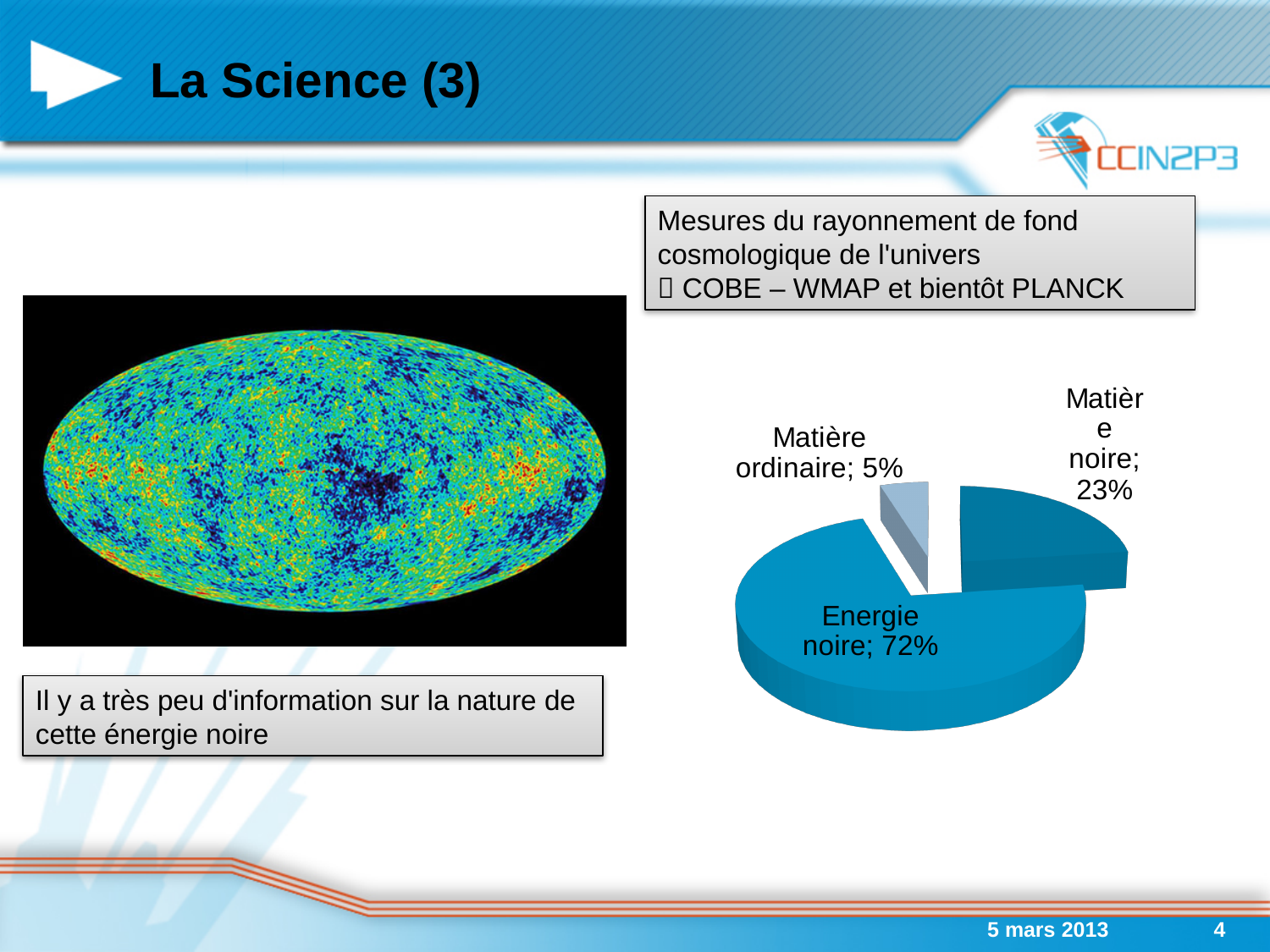
What is the difference between the values for Matière noire and Matière ordinaire? 18% What kind of chart is shown on the slide? pie chart Which is larger, Matière noire or Matière ordinaire? Matière noire Which slice of the pie is shown in a lighter colour than the others? Matière ordinaire What is the value for Matière noire? 23% How many slices does the pie chart have? 3 What is the value for Matière ordinaire? 5% What is the value for Energie noire? 72% Which slice of the pie is the smallest? Matière ordinaire Which slice of the pie is the largest? Energie noire What is the difference between the values for Energie noire and Matière noire? 49% What share of the pie does Matière noire represent? 23%